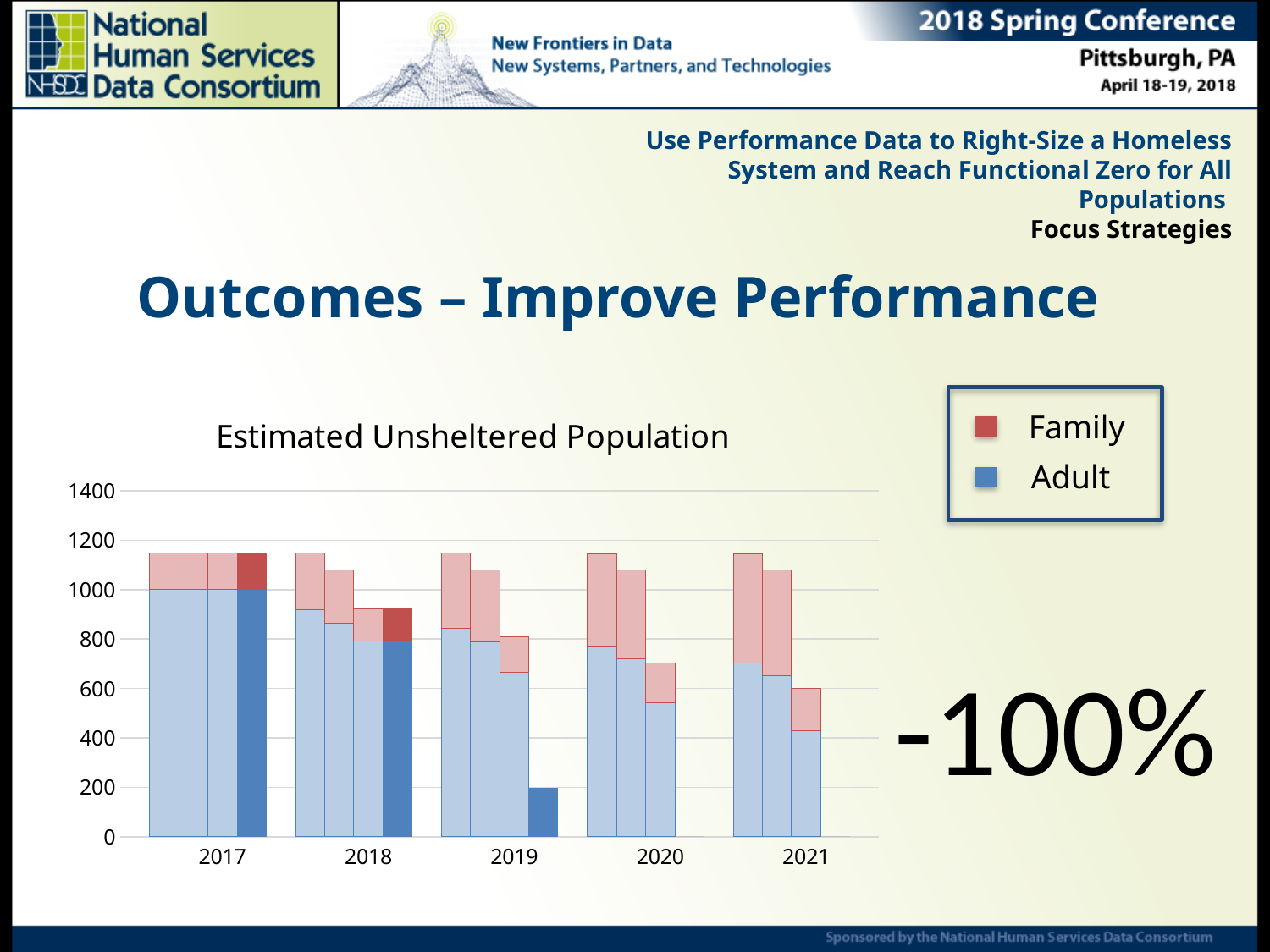
Is the total of the tallest bar for 2017 greater or less than 1000? greater Which series is stacked at the bottom of each bar? Adult What type of chart is shown on the slide? bar chart How many years are shown along the x axis? 5 Is the Adult portion of the first bar for 2020 greater or less than 600? greater What is the title of the chart? Estimated Unsheltered Population Which two series are listed in the legend? Family and Adult Within 2021, do the bar totals rise or fall from left to right? fall Is the total of the third bar for 2021 greater or less than 800? less How many series does the legend list? 2